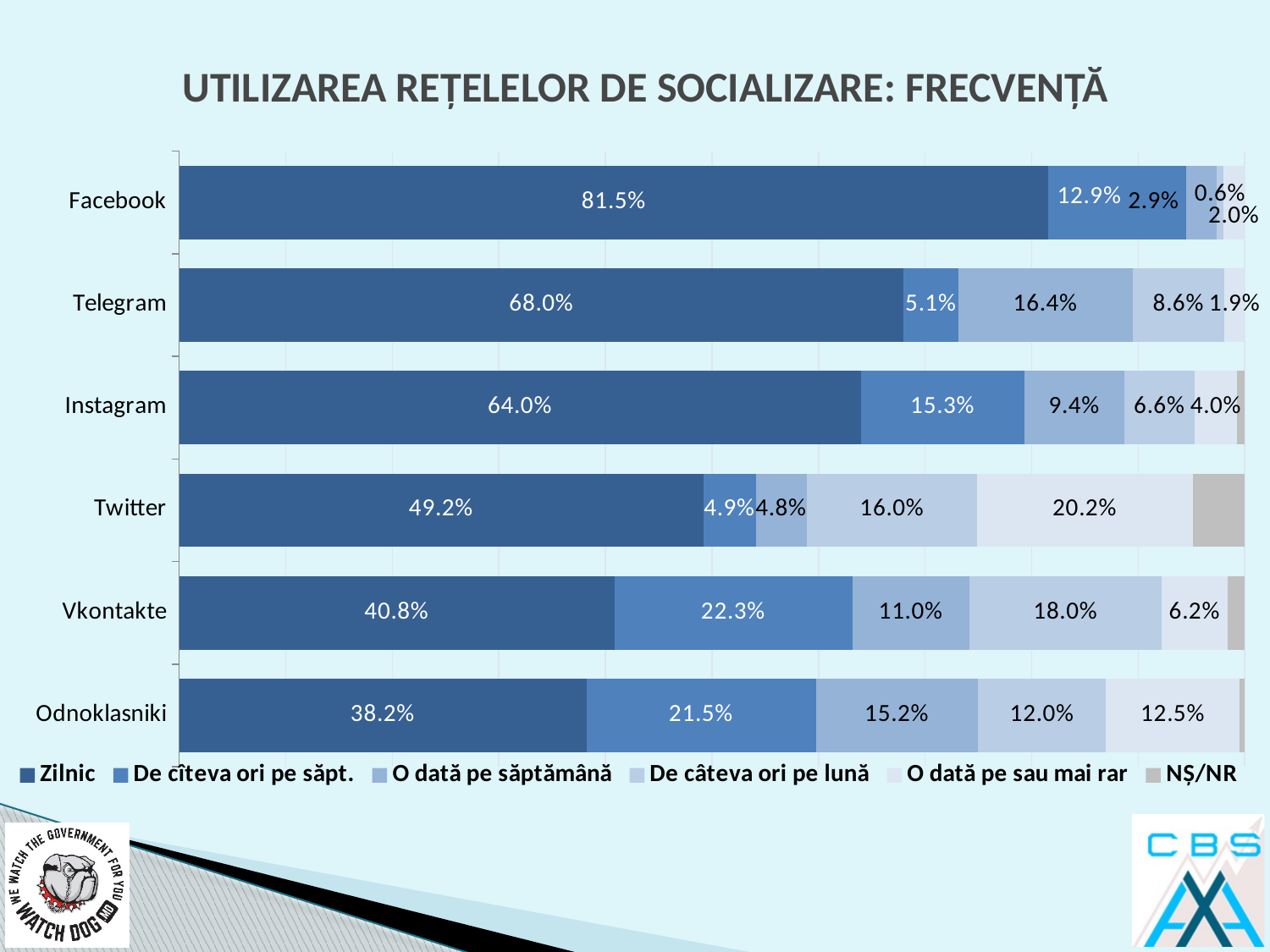
Which social network has the lowest 'Zilnic' value? Odnoklasniki What is the 'Zilnic' value for Facebook? 81.5% What kind of chart is shown on the slide? Stacked bar chart What is the difference between the 'Zilnic' values for Facebook and Telegram? 13.5% Which is larger: the 'Zilnic' value for Instagram or for Twitter? Instagram Which social network has the highest 'Zilnic' value? Facebook What is the 'De cîteva ori pe săpt.' value for Vkontakte? 22.3% What is the title of the chart? UTILIZAREA REȚELELOR DE SOCIALIZARE: FRECVENȚĂ What is the 'O dată pe sau mai rar' value for Twitter? 20.2% How many series does the legend list? 6 What is the 'Zilnic' value for Odnoklasniki? 38.2% How many social networks are shown on the chart? 6